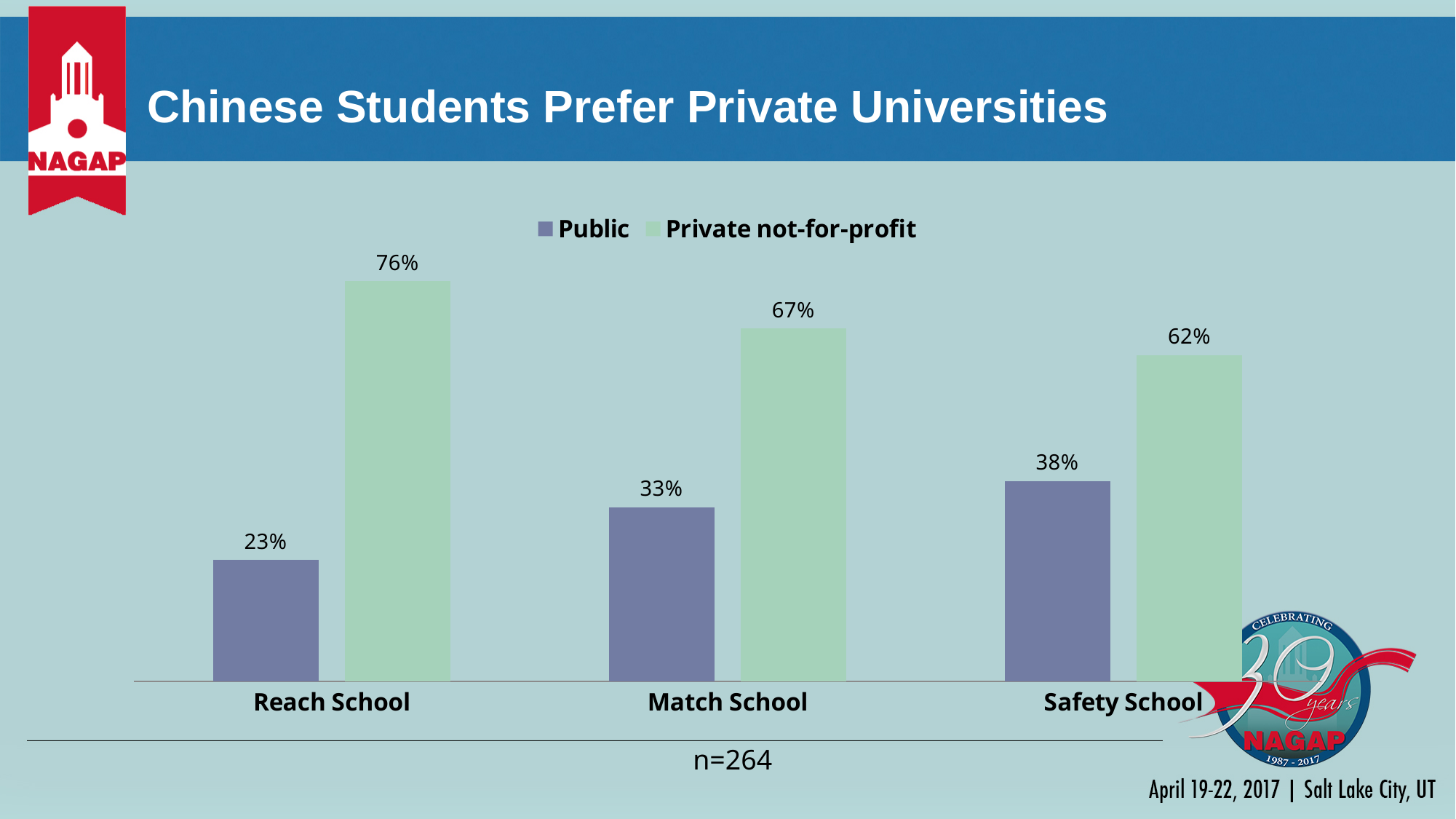
What is the Public value for Safety School? 38% Which category has the highest Private not-for-profit value? Reach School What is the difference between the Private not-for-profit and Public values for Reach School? 53% What is the Private not-for-profit value for Match School? 67% What is the Public value for Reach School? 23% How many categories are shown on the x axis? 3 How many series does the legend list? 2 What kind of chart is shown on the slide? Bar chart What is the difference between the Public values for Safety School and Match School? 5% Which category has the lowest Public value? Reach School Do the Private not-for-profit values rise or fall from Reach School to Safety School? Fall Which is larger for Safety School, the Public value or the Private not-for-profit value? Private not-for-profit